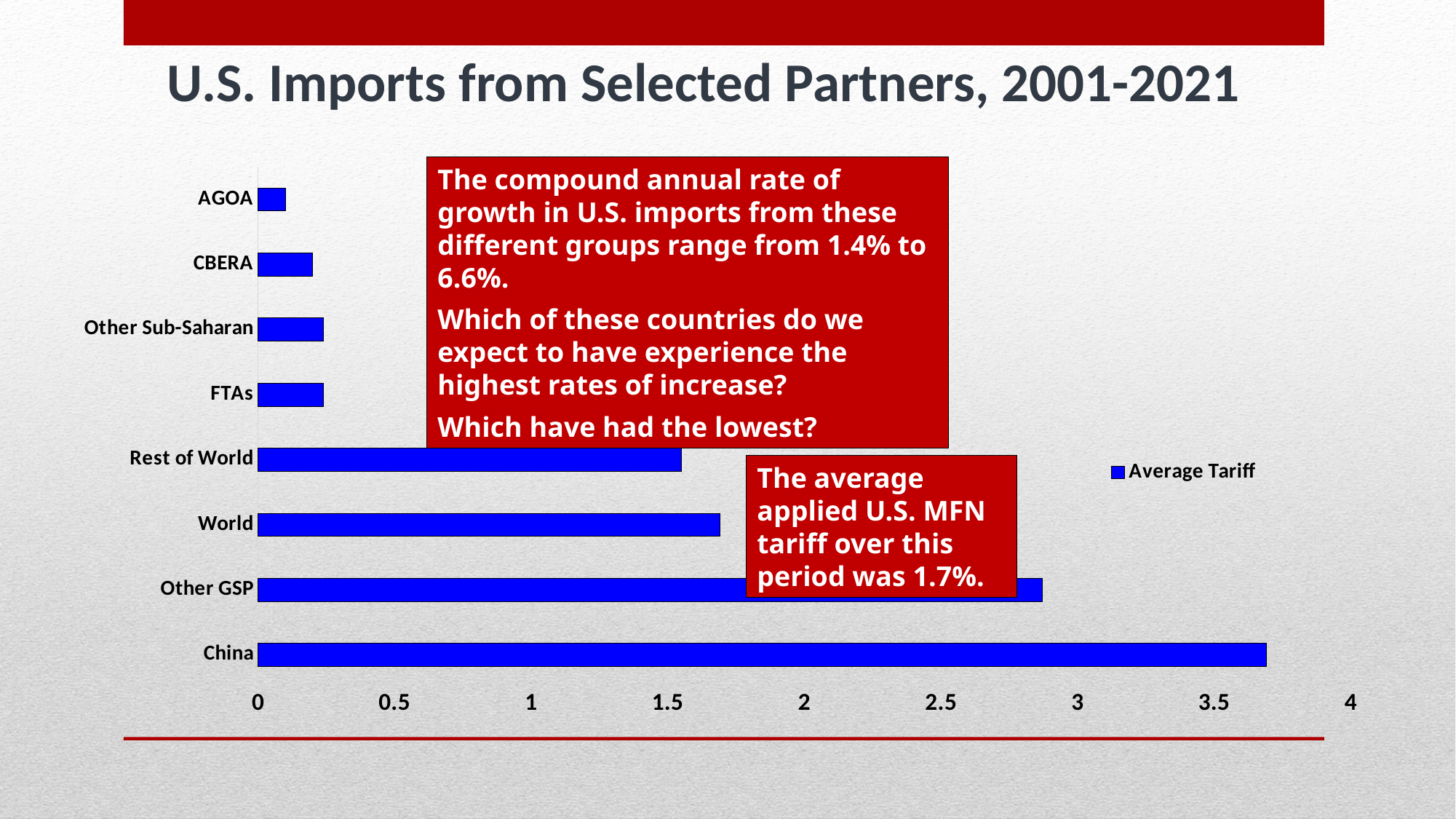
Is the value for China greater or less than 3.5? greater How many series does the legend list? 1 How many categories are plotted in the chart? 8 Which has a larger value, World or Rest of World? World Which category has the lowest value in the chart? AGOA What series name is shown in the chart legend? Average Tariff Is the value for World greater or less than 2? less Which category has the highest value in the chart? China What kind of chart is shown on the slide? Bar chart Is the value for AGOA greater or less than 0.5? less Which has a larger value, China or Other GSP? China